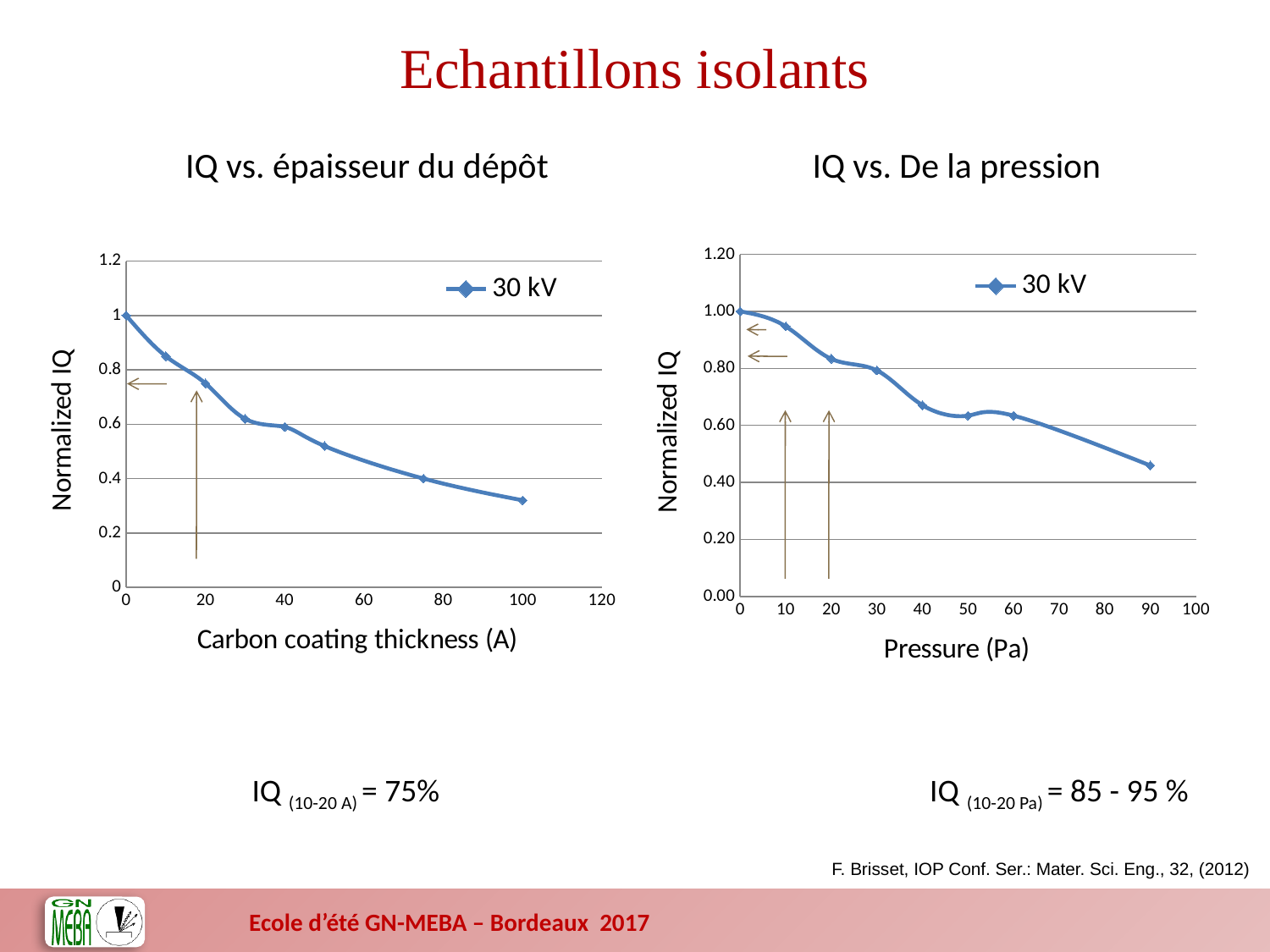
In the left chart, 'IQ vs. épaisseur du dépôt', do the values rise or fall as carbon coating thickness increases? fall In the left chart, 'IQ vs. épaisseur du dépôt', is the Normalized IQ at a carbon coating thickness of 100 A greater or less than 0.4? less In the left chart, 'IQ vs. épaisseur du dépôt', how many data points are plotted? 8 In the right chart, 'IQ vs. De la pression', is the Normalized IQ at a pressure of 40 Pa greater or less than 0.60? greater What kind of chart is the left chart, 'IQ vs. épaisseur du dépôt'? line chart In the right chart, 'IQ vs. De la pression', what is the x-axis title? Pressure (Pa) In the right chart, 'IQ vs. De la pression', is the Normalized IQ at a pressure of 90 Pa greater or less than 0.60? less In the right chart, 'IQ vs. De la pression', do the values rise or fall as pressure increases? fall How many series does the legend of the right chart, 'IQ vs. De la pression', list? 1 In the right chart, 'IQ vs. De la pression', how many data points are plotted? 8 In the left chart, 'IQ vs. épaisseur du dépôt', what is the name of the series shown in the legend? 30 kV